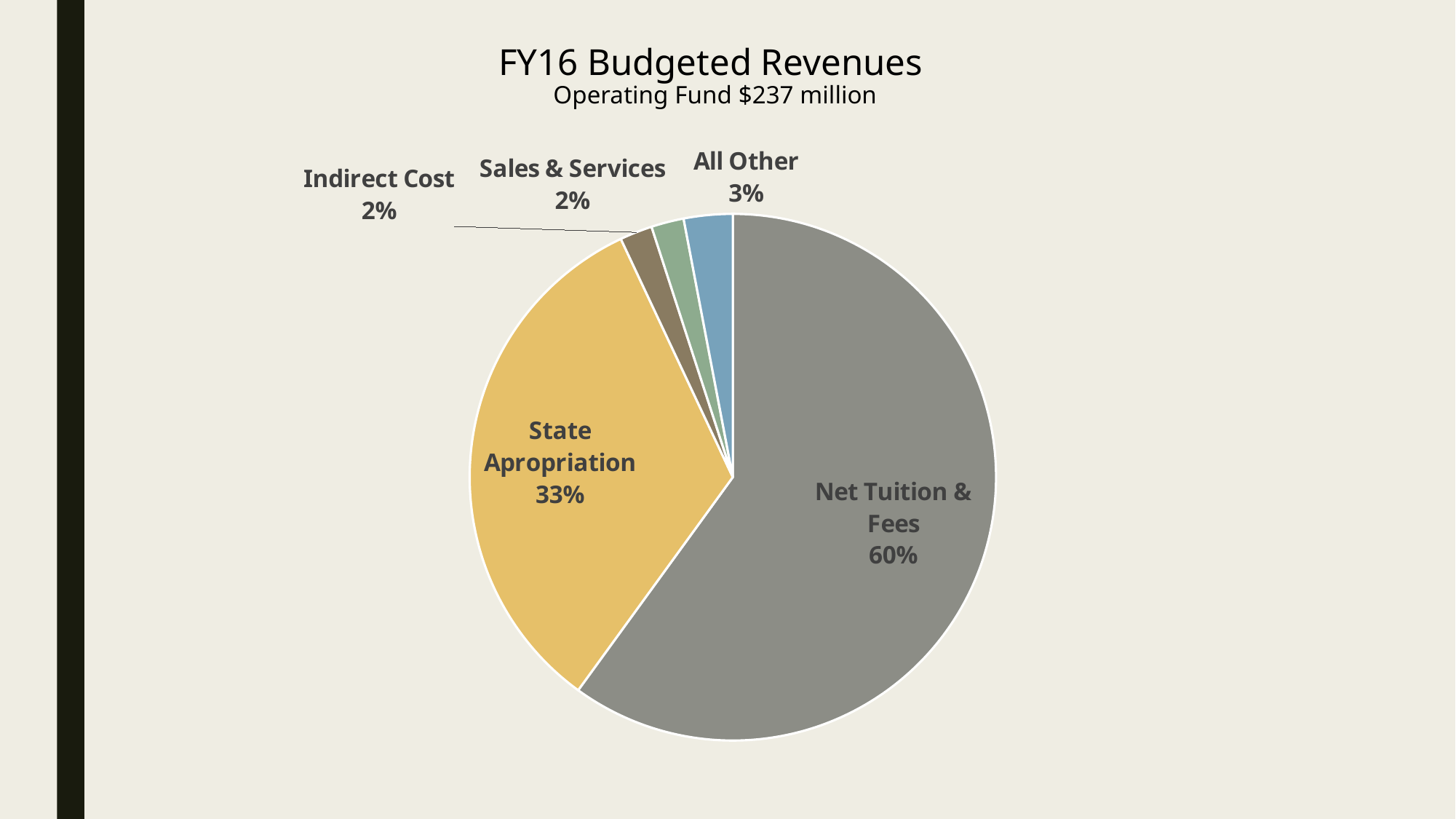
What share of FY16 budgeted revenues comes from Sales & Services? 2% What share of FY16 budgeted revenues comes from Net Tuition & Fees? 60% How many slices does the pie chart have? 5 What share of FY16 budgeted revenues comes from All Other? 3% Which category has the largest share of FY16 budgeted revenues? Net Tuition & Fees What is the difference in percentage points between Net Tuition & Fees and State Apropriation? 27 What is the total Operating Fund amount shown in the chart subtitle? $237 million Which is larger, the share for All Other or the share for Sales & Services? All Other What kind of chart is shown on the slide? pie chart What is the title of the chart? FY16 Budgeted Revenues